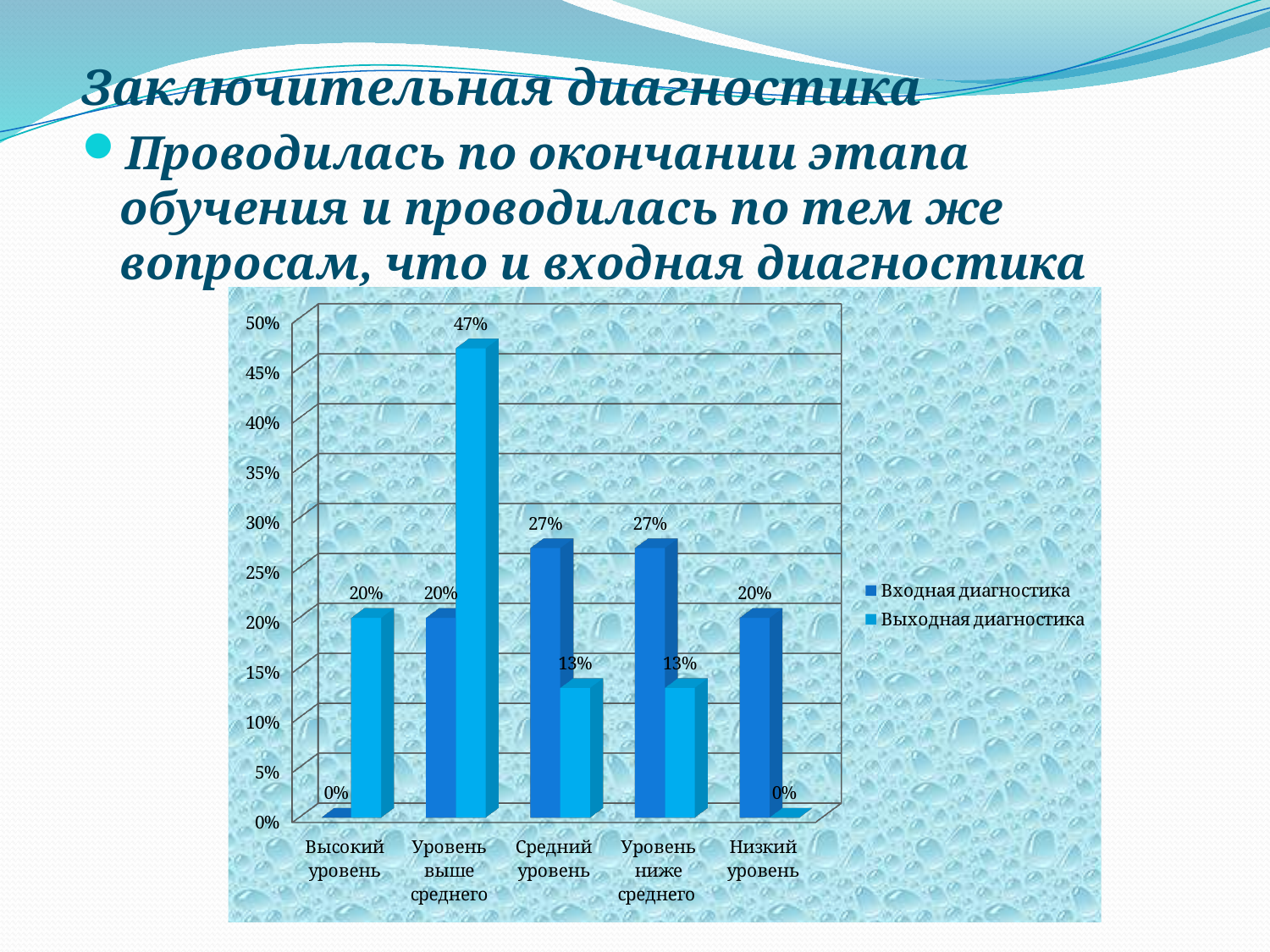
What are the two legend entries of the chart? Входная диагностика, Выходная диагностика What is the value of Входная диагностика for Средний уровень? 27% How many series does the legend list? 2 What is the value of Выходная диагностика for Уровень выше среднего? 47% What is the value of Входная диагностика for Высокий уровень? 0% What is the difference between Выходная диагностика and Входная диагностика for Уровень выше среднего? 27% What is the value of Выходная диагностика for Низкий уровень? 0% Which is larger for Уровень ниже среднего: Входная диагностика or Выходная диагностика? Входная диагностика What type of chart is shown on the slide? Bar chart Which category has the lowest value for Входная диагностика? Высокий уровень Which category has the highest value for Выходная диагностика? Уровень выше среднего How many categories are shown on the x axis? 5